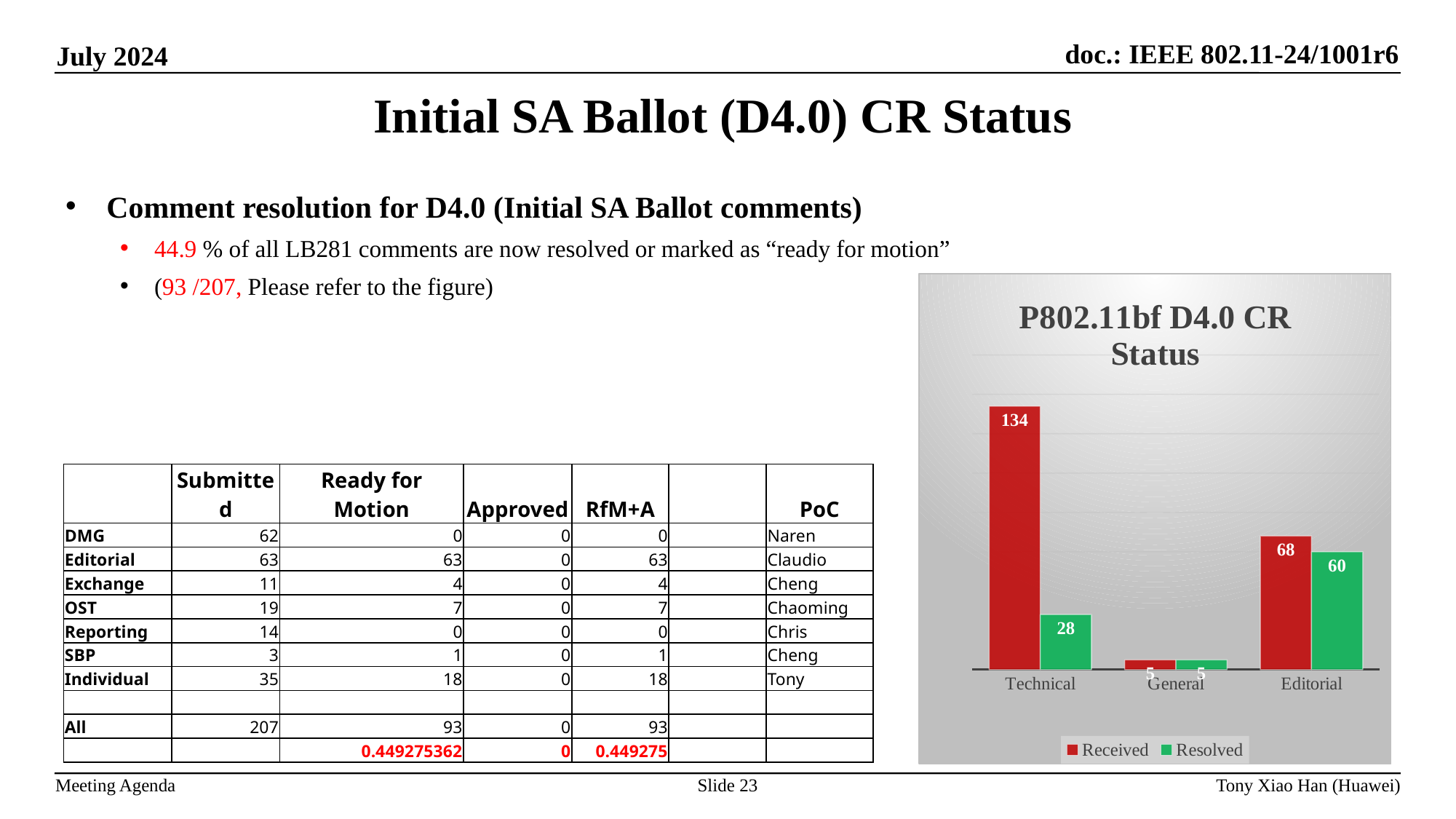
Which category has the lowest Resolved value in the chart? General What is the Received value for Technical in the chart? 134 What type of chart is shown on the slide? Bar chart What is the Received value for Editorial in the chart? 68 What is the Resolved value for Editorial in the chart? 60 How many categories are shown on the x axis of the chart? 3 How many series does the chart legend list? 2 What is the difference between Received and Resolved for Technical in the chart? 106 What is the Resolved value for Technical in the chart? 28 Which category has the highest Received value in the chart? Technical What is the difference between Received and Resolved for Editorial in the chart? 8 Which is larger in the chart: Resolved for Editorial or Resolved for Technical? Resolved for Editorial